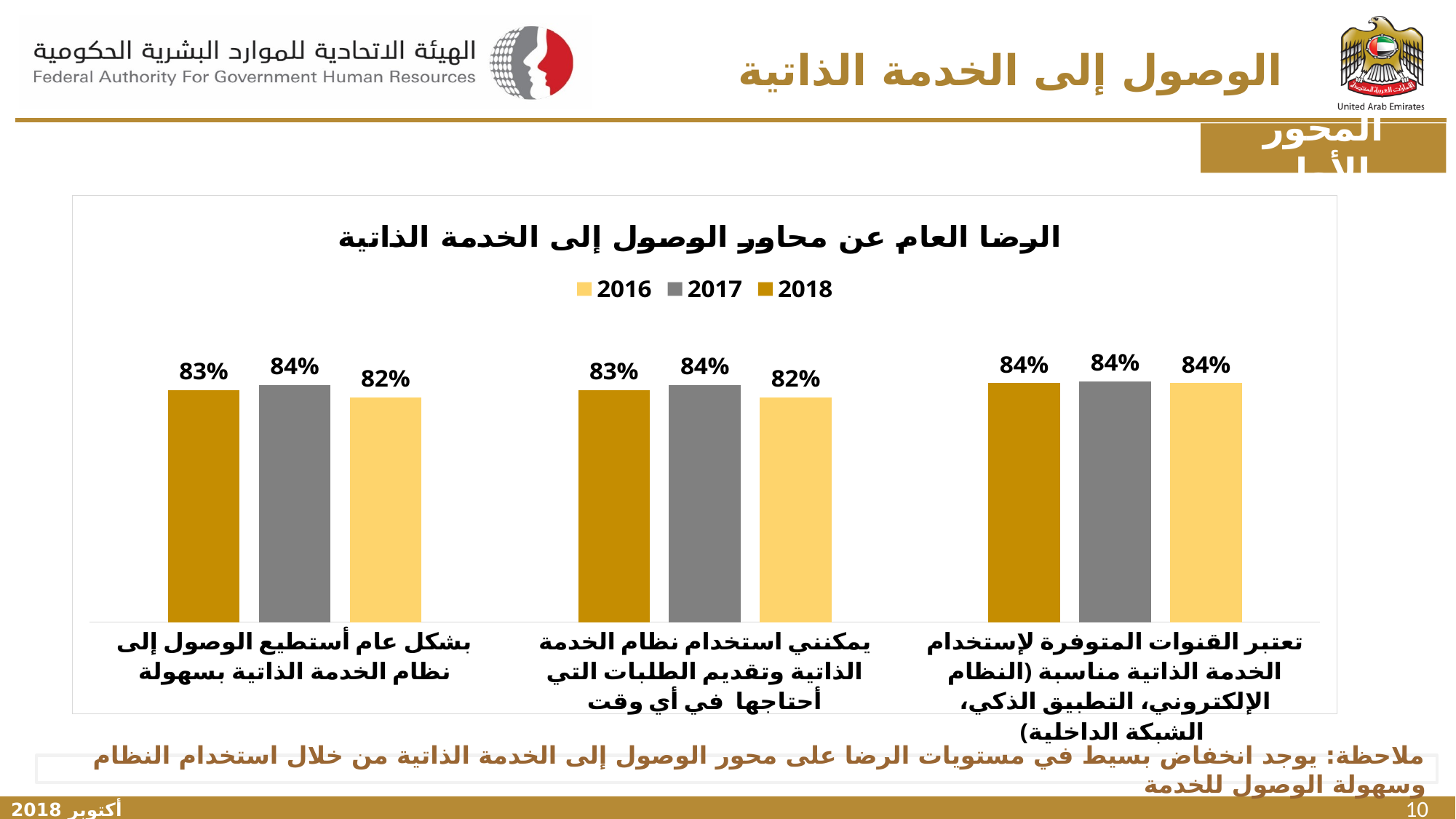
What is the 2018 value for the category 'بشكل عام أستطيع الوصول إلى نظام الخدمة الذاتية بسهولة' (left group)? 83% How many categories are shown on the x axis of the chart? 3 What is the 2017 value for the category 'تعتبر القنوات المتوفرة لإستخدام الخدمة الذاتية مناسبة' (right group)? 84% Which years are listed in the chart legend? 2016, 2017, 2018 What type of chart is shown on the slide? bar chart In the left group ('بشكل عام أستطيع الوصول إلى نظام الخدمة الذاتية بسهولة'), which year has the highest value? 2017 What is the difference between the 2017 and 2016 values in the left group ('بشكل عام أستطيع الوصول إلى نظام الخدمة الذاتية بسهولة')? 2% How many series does the chart legend list? 3 In the right group ('تعتبر القنوات المتوفرة لإستخدام الخدمة الذاتية مناسبة'), is the 2018 value larger than, smaller than, or equal to the 2016 value? equal What is the 2016 value for the category 'يمكنني استخدام نظام الخدمة الذاتية وتقديم الطلبات التي أحتاجها في أي وقت' (middle group)? 82% What is the title of the chart? الرضا العام عن محاور الوصول إلى الخدمة الذاتية In the middle group ('يمكنني استخدام نظام الخدمة الذاتية وتقديم الطلبات التي أحتاجها في أي وقت'), which year has the lowest value? 2016